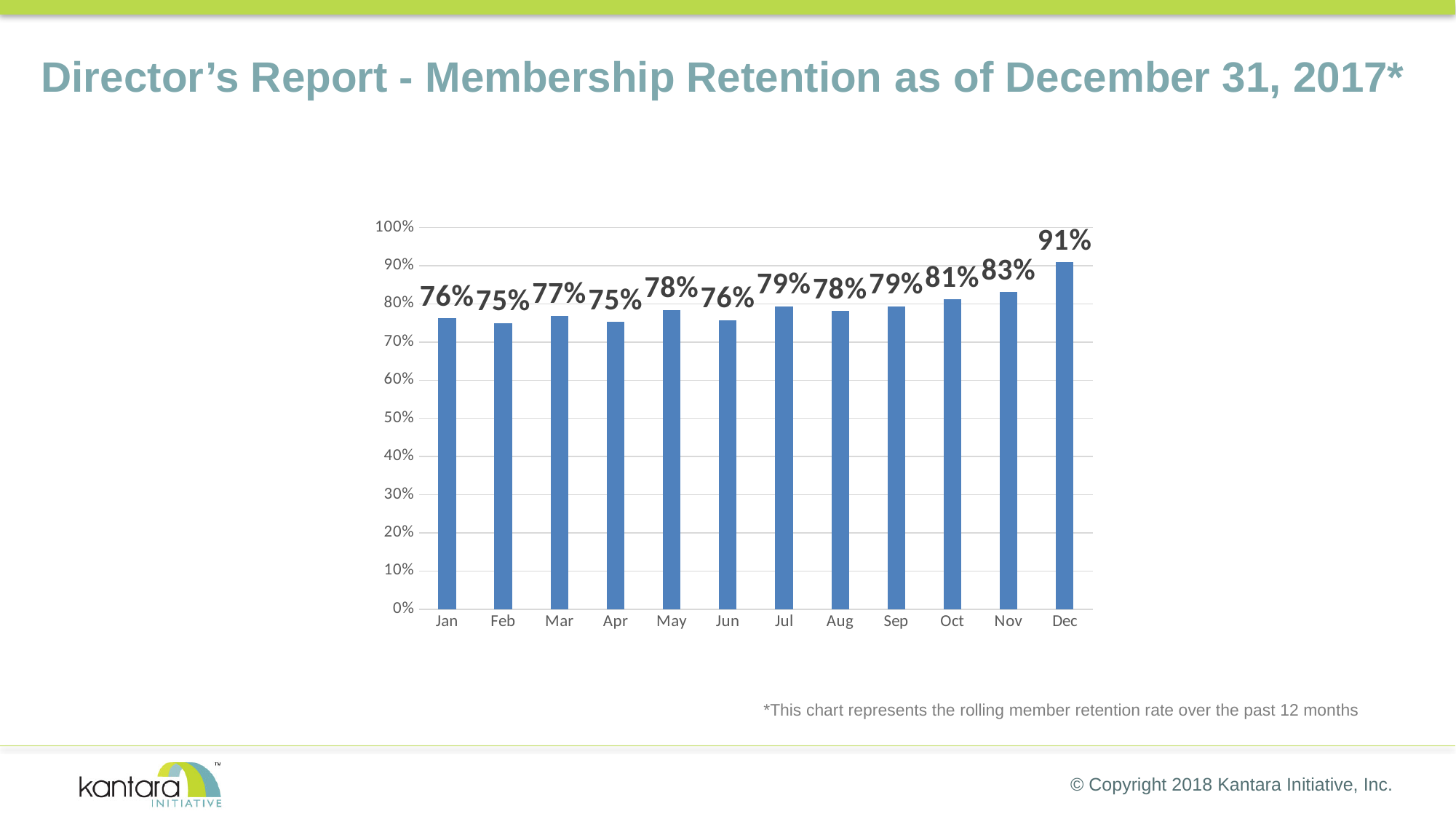
Do the retention rates generally rise or fall from Sep to Dec? Rise Is the retention rate for Dec greater or less than 90%? greater Which month has the highest retention rate? Dec What is the difference between the retention rates for Jul and Feb? 4% Which is larger, the retention rate for Nov or for Sep? Nov How many months are shown on the x axis? 12 What is the membership retention rate for Dec? 91% What kind of chart is shown on the slide? Bar chart Is the retention rate for Apr greater or less than 80%? less What is the membership retention rate for Jan? 76% What is the difference between the retention rates for Dec and Nov? 8% What is the membership retention rate for Oct? 81%